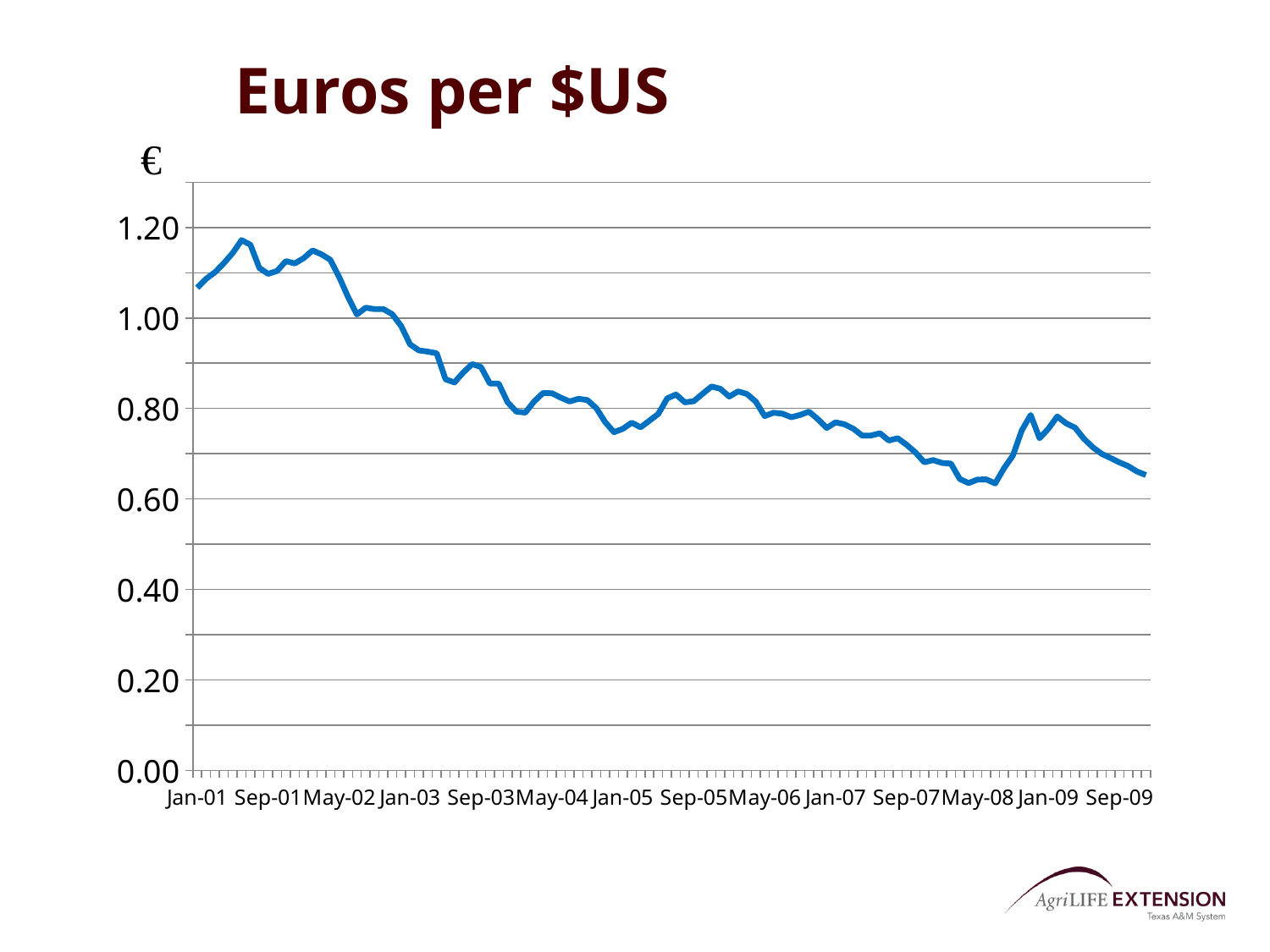
Which is larger, the value for May-08 or the value for Jan-09? Jan-09 Is the value for Jan-01 greater or less than 1.00? greater Overall, do the values rise or fall from Jan-01 to Sep-09? fall Is the value for May-08 greater or less than 0.80? less What kind of chart is shown on the slide? line chart Is the value for Jan-03 greater or less than 1.00? less How many date labels are shown along the x axis? 14 What is the title of the chart? Euros per $US Which is larger, the value for Jan-01 or the value for Sep-09? Jan-01 What symbol labels the vertical axis of the chart? €